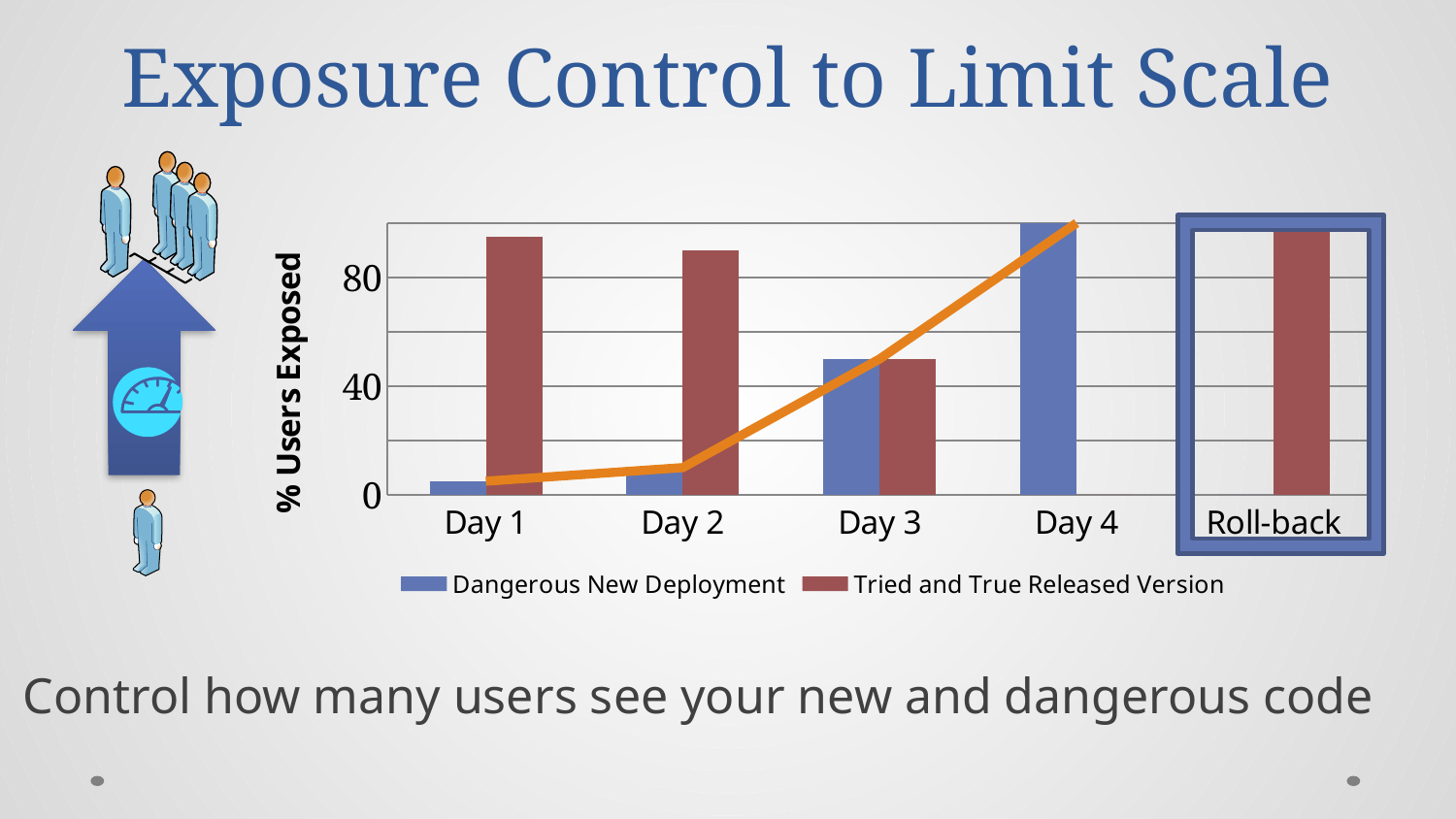
On Day 1, which series has the larger value: Dangerous New Deployment or Tried and True Released Version? Tried and True Released Version Is the value for Tried and True Released Version on Day 1 greater or less than 80? greater What kind of chart is shown on the slide? Bar and line chart Is the value for Dangerous New Deployment on Day 2 greater or less than 40? less How many series does the chart's legend list? 2 Is the value for Tried and True Released Version at Roll-back greater or less than 80? greater Do the values for Dangerous New Deployment rise or fall from Day 1 to Day 4? Rise How many categories are shown on the x axis of the chart? 5 On Day 4, which series has the larger value: Dangerous New Deployment or Tried and True Released Version? Dangerous New Deployment Which category has the highest value for Dangerous New Deployment? Day 4 What is the label on the chart's vertical axis? % Users Exposed